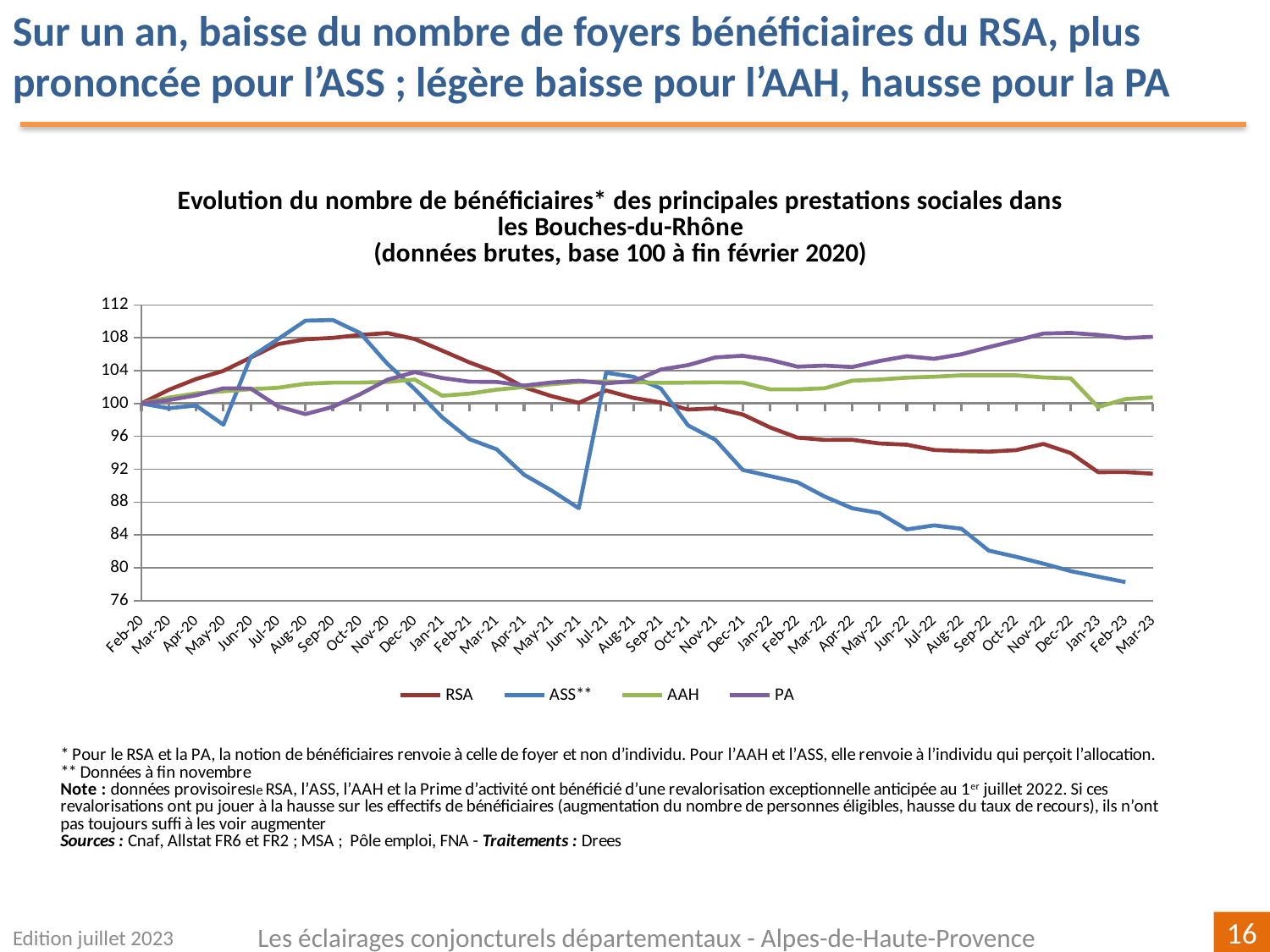
Does the ASS** series rise or fall between Sep-21 and Mar-23? fall Which series is highest at Mar-23? PA At Dec-20, which series has the larger value, RSA or ASS**? RSA Which series is lowest at Mar-23? RSA At Mar-23, which series has the larger value, RSA or AAH? AAH Is the value for PA at Nov-22 greater or less than 104? greater Is the value for RSA at Mar-23 greater or less than 96? less What is the base period used for the index of 100 according to the chart title? fin février 2020 What kind of chart is shown on the slide? line chart Is the value for ASS** at Sep-20 greater or less than 108? greater How many series does the legend list? 4